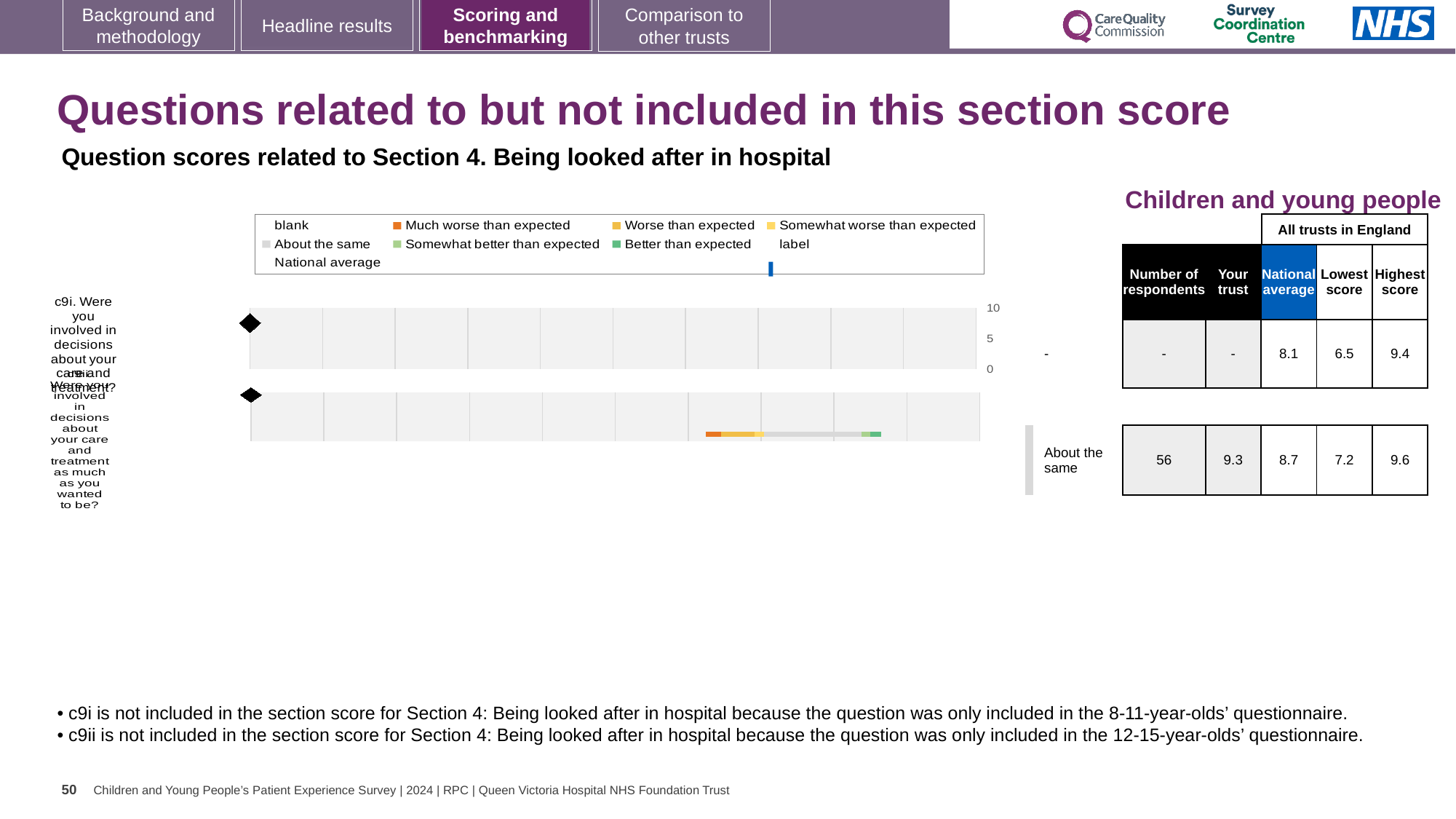
In the table next to the chart, what is the 'Your trust' score for c9ii? 9.3 In the table next to the chart, what is the highest score for c9i? 9.4 How many questions (rows) are plotted on the chart? 2 For c9ii, which is larger: the 'Your trust' score or the national average? Your trust In the table next to the chart, what is the national average for c9i? 8.1 What benchmark category is shown for c9ii? About the same For c9ii, what is the difference between the 'Your trust' score and the national average? 0.6 In the table next to the chart, what is the number of respondents for c9ii? 56 Which colour represents 'Much worse than expected' in the chart legend? orange What is the maximum value shown on the chart's score axis? 10 In the table next to the chart, what is the national average for c9ii? 8.7 What kind of chart is shown on the slide? bar chart